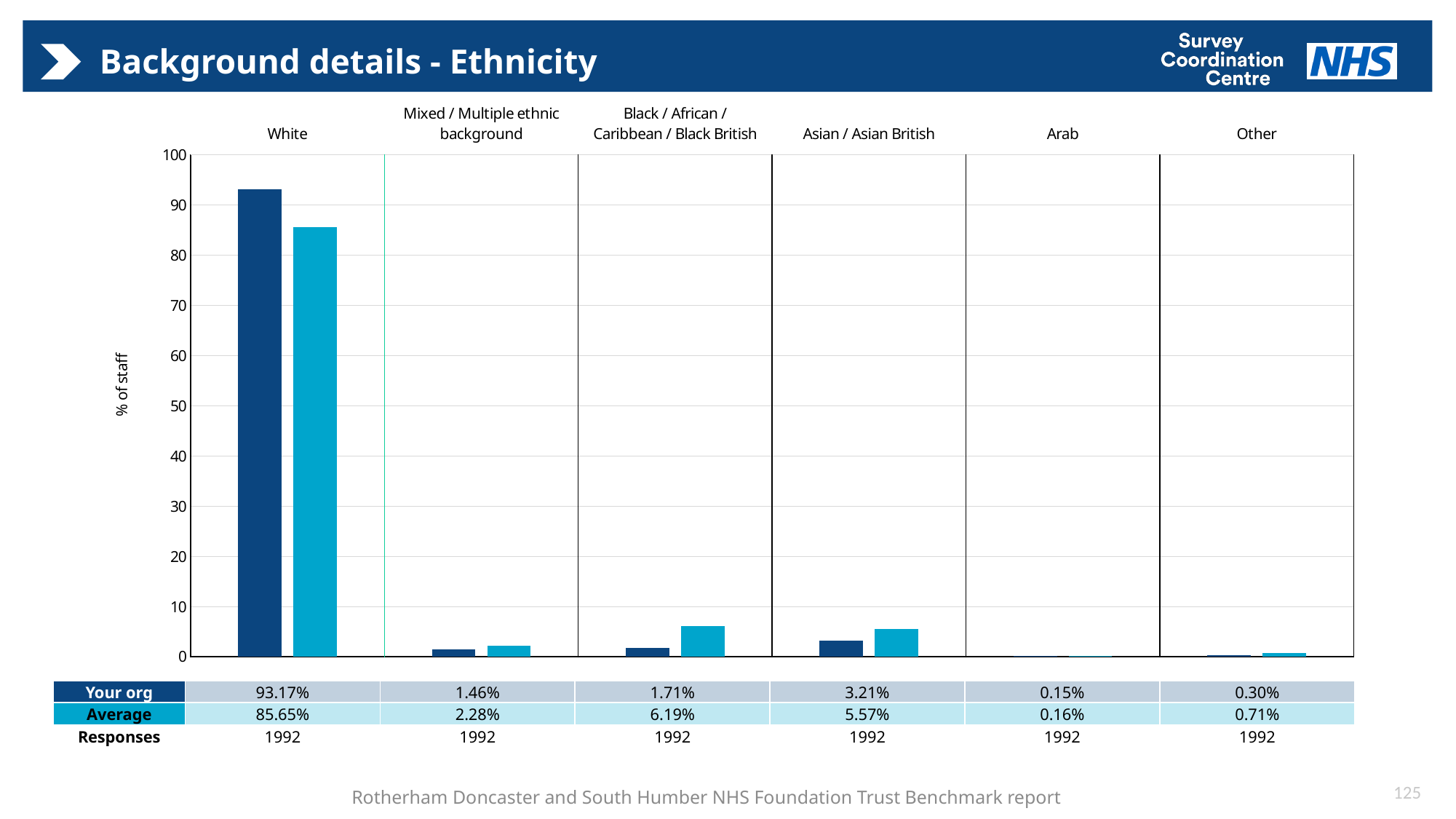
How many series does the chart show? 2 What is the difference between the Average and 'Your org' values for Black / African / Caribbean / Black British? 4.48 percentage points What is the 'Your org' value for White? 93.17% For Asian / Asian British, which is larger: the 'Your org' value or the Average value? Average What is the difference between the 'Your org' and Average values for White? 7.52 percentage points Which ethnicity category has the highest 'Your org' value? White What type of chart is shown on the slide? Bar chart What is the Average value for Black / African / Caribbean / Black British? 6.19% What is the Average value for Other? 0.71% Which ethnicity category has the lowest Average value? Arab What is the 'Your org' value for Asian / Asian British? 3.21% How many ethnicity categories are shown on the chart? 6